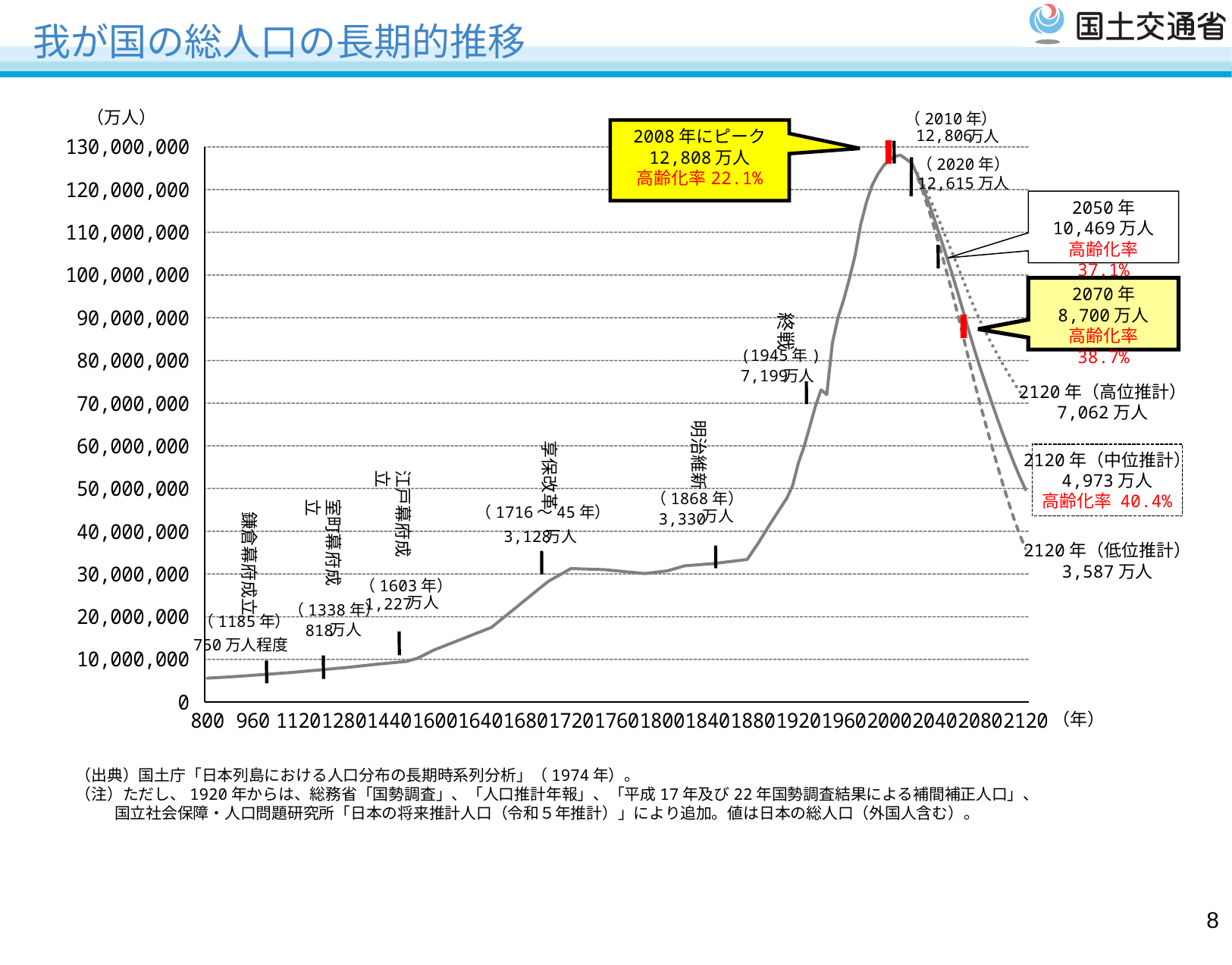
Which is larger, the population labelled for 1945 (7,199万人) or for 1868 (3,330万人)? 1945 (7,199万人) What is the projected population for 2070? 8,700万人 What is the population value labelled for 2020? 12,615万人 Does the population line rise or fall between 1920 and 2008? rise What is the aging rate (高齢化率) shown for the 2008 peak? 22.1% What kind of chart is shown on the slide? line chart What is the title of the chart on the slide? 我が国の総人口の長期的推移 What was the total population at the 2008 peak? 12,808万人 What is the difference between the 2120 high projection (7,062万人) and the 2120 low projection (3,587万人)? 3,475万人 In which year does the chart say Japan's total population peaked? 2008年 What is the aging rate shown for 2050? 37.1% What is the 2120 medium projection (中位推計) population? 4,973万人